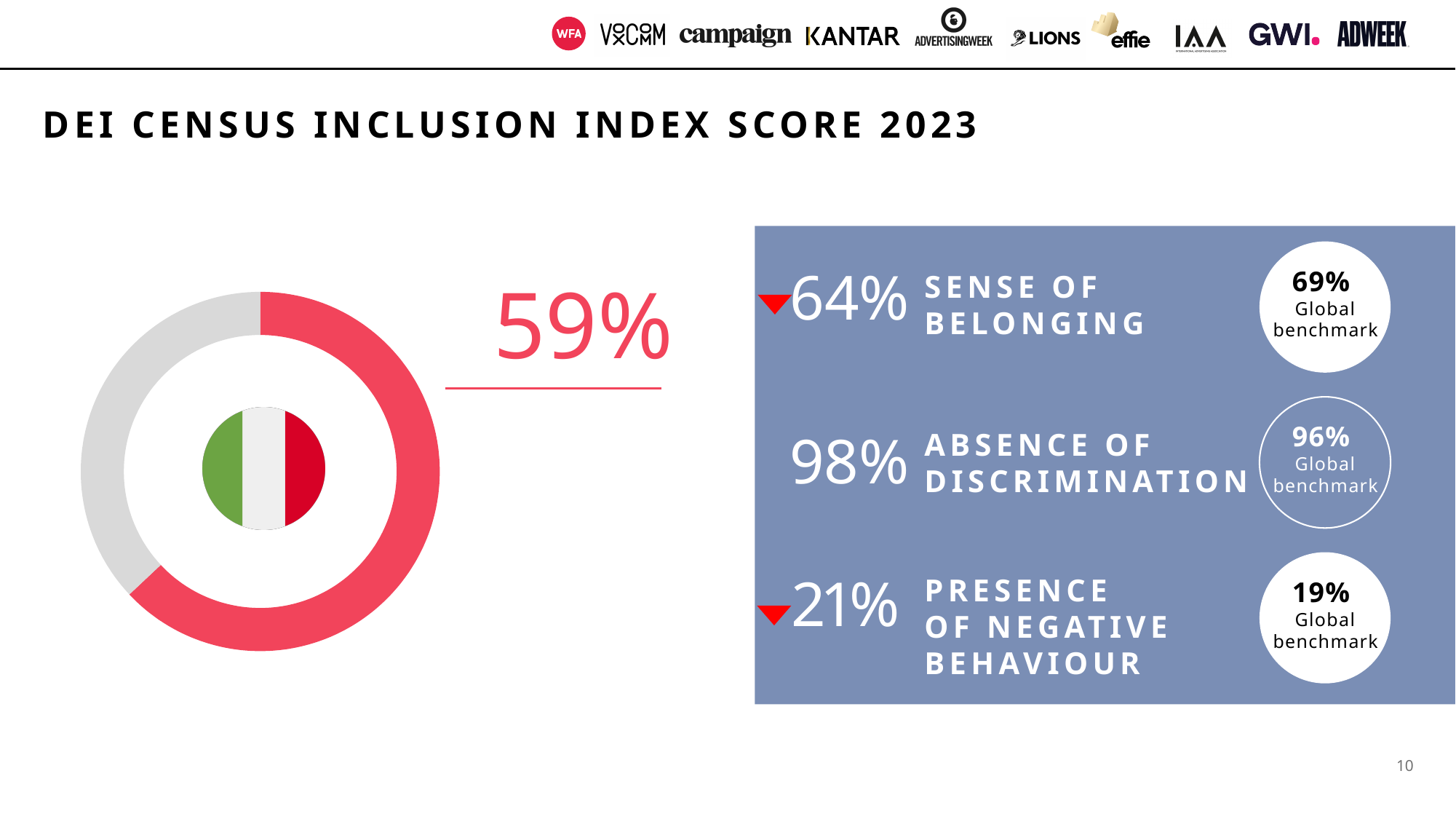
What is the title of the slide containing the donut chart? DEI Census Inclusion Index Score 2023 How many segments does the donut chart have? 2 What kind of chart is shown on the left of the slide? Donut chart Is the value shown by the donut chart greater or less than 50%? greater What share of the donut chart is filled in red? 59% In the panel on the right, which is larger: the Presence of Negative Behaviour score or its global benchmark? Presence of Negative Behaviour score (21%) Which country's flag appears in the centre of the donut chart? Italy In the panel on the right, what is the score for Sense of Belonging? 64% In the panel on the right, what is the global benchmark for Absence of Discrimination? 96% What share of the donut chart is left grey (unfilled)? 41% In the panel on the right, what is the difference between the Sense of Belonging score (64%) and its global benchmark (69%)? 5% What value does the donut chart on the left display? 59%